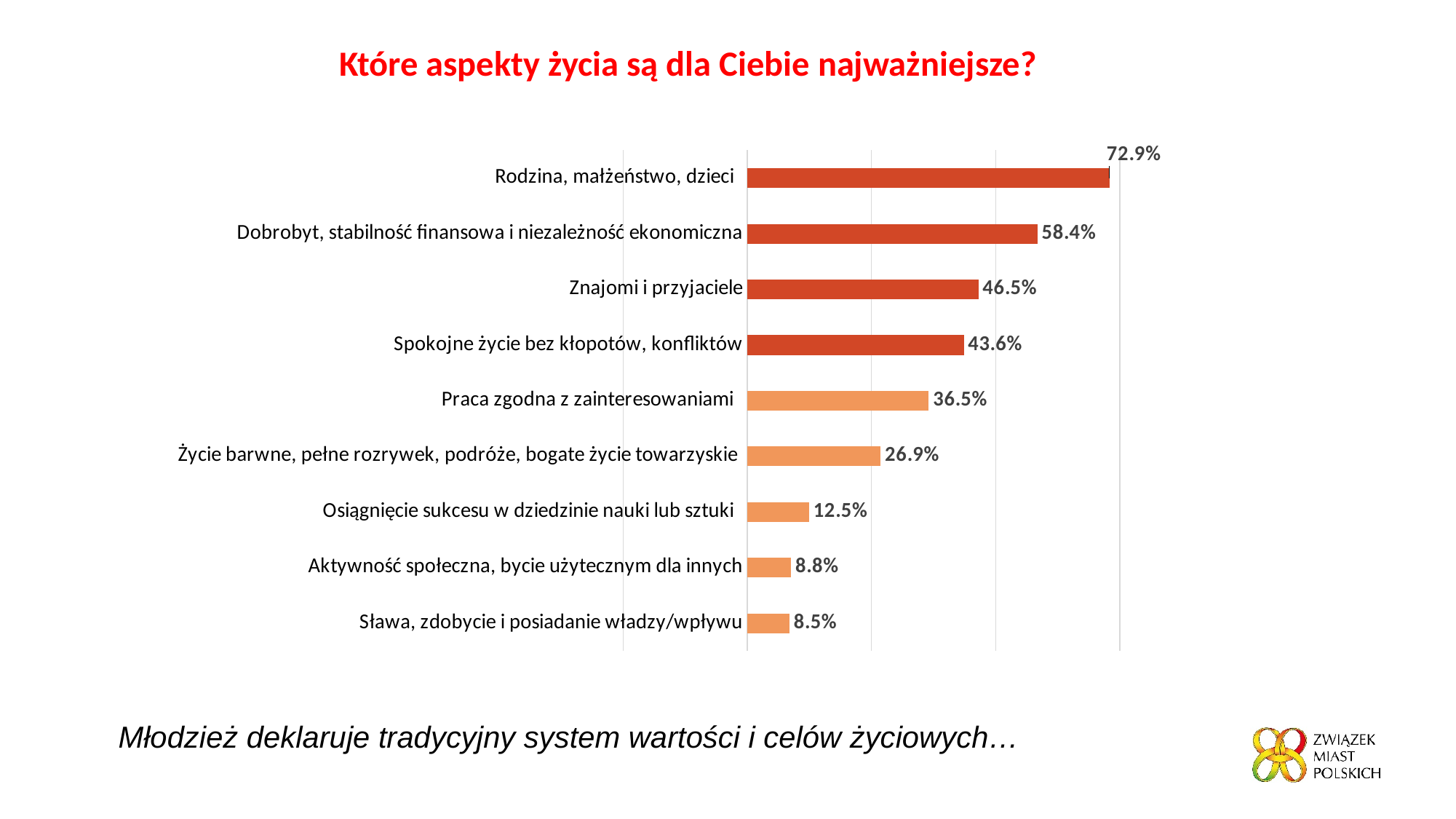
What is the value for "Praca zgodna z zainteresowaniami"? 36.5% What is the value for "Rodzina, małżeństwo, dzieci"? 72.9% What is the title of the chart? Które aspekty życia są dla Ciebie najważniejsze? What is the difference between the values for "Dobrobyt, stabilność finansowa i niezależność ekonomiczna" and "Znajomi i przyjaciele"? 11.9% What is the value for "Osiągnięcie sukcesu w dziedzinie nauki lub sztuki"? 12.5% What is the difference between the values for "Aktywność społeczna, bycie użytecznym dla innych" and "Sława, zdobycie i posiadanie władzy/wpływu"? 0.3% How many bars are drawn in the lighter orange colour? 5 What kind of chart is shown on the slide? Bar chart Which category has the highest value? Rodzina, małżeństwo, dzieci How many categories are shown in the chart? 9 Which category has the lowest value? Sława, zdobycie i posiadanie władzy/wpływu Which is larger: the value for "Znajomi i przyjaciele" or the value for "Spokojne życie bez kłopotów, konfliktów"? Znajomi i przyjaciele